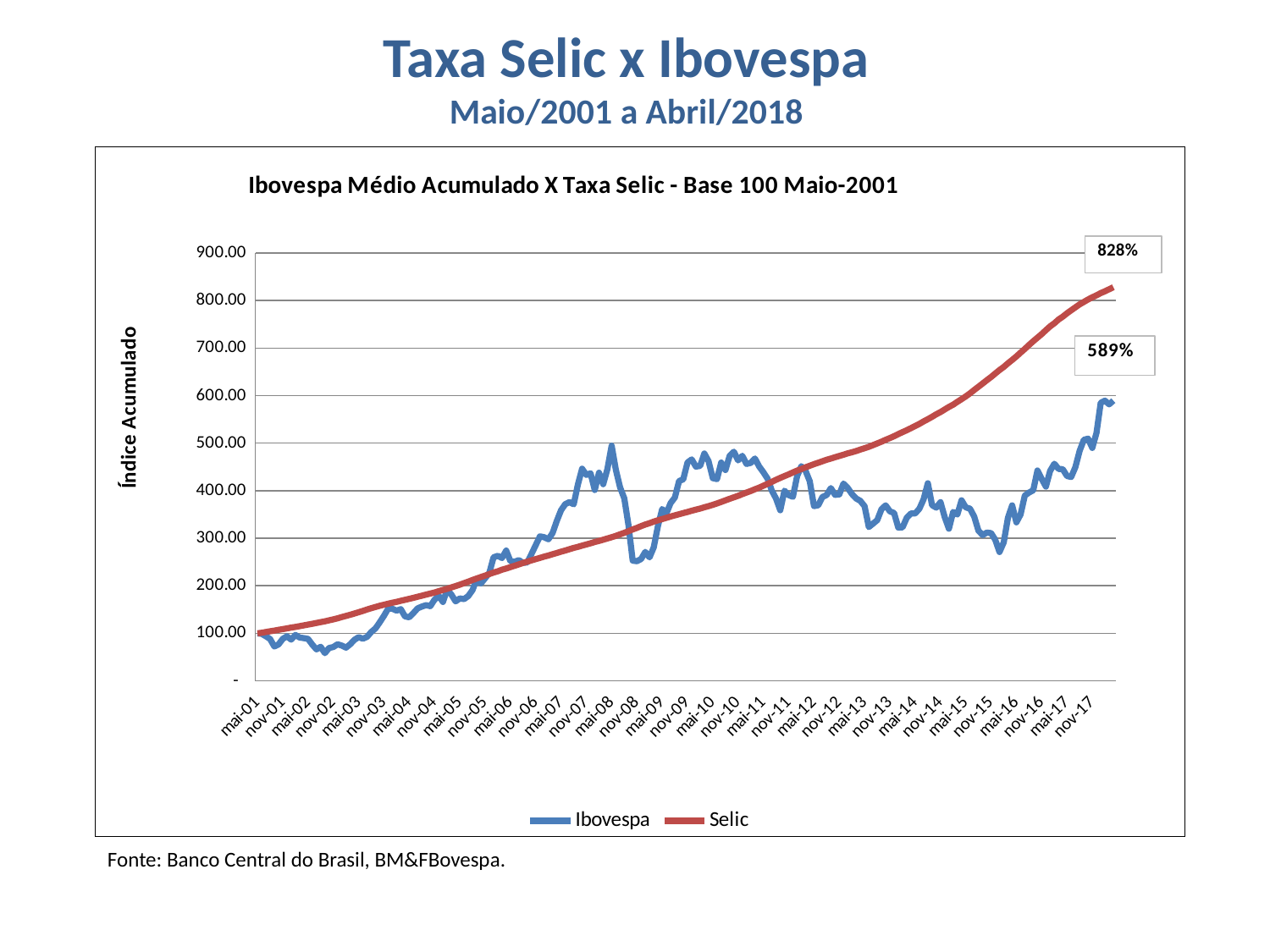
What are the two series named in the chart's legend? Ibovespa and Selic How many series does the chart's legend list? 2 Is the value of the Ibovespa line at nov-08 greater or less than 300? less What kind of chart is shown on the slide? Line chart What value is labelled at the end of the Ibovespa line? 589% What value is labelled at the end of the Selic line? 828% Does the Selic line rise or fall along the x axis from mai-01 to nov-17? Rise What is the difference between the final labelled values of Selic (828%) and Ibovespa (589%)? 239 percentage points Which series ends higher at the right end of the chart, Selic or Ibovespa? Selic What is the title printed inside the chart area? Ibovespa Médio Acumulado X Taxa Selic - Base 100 Maio-2001 Is the value of the Selic line at mai-10 greater or less than 300? greater